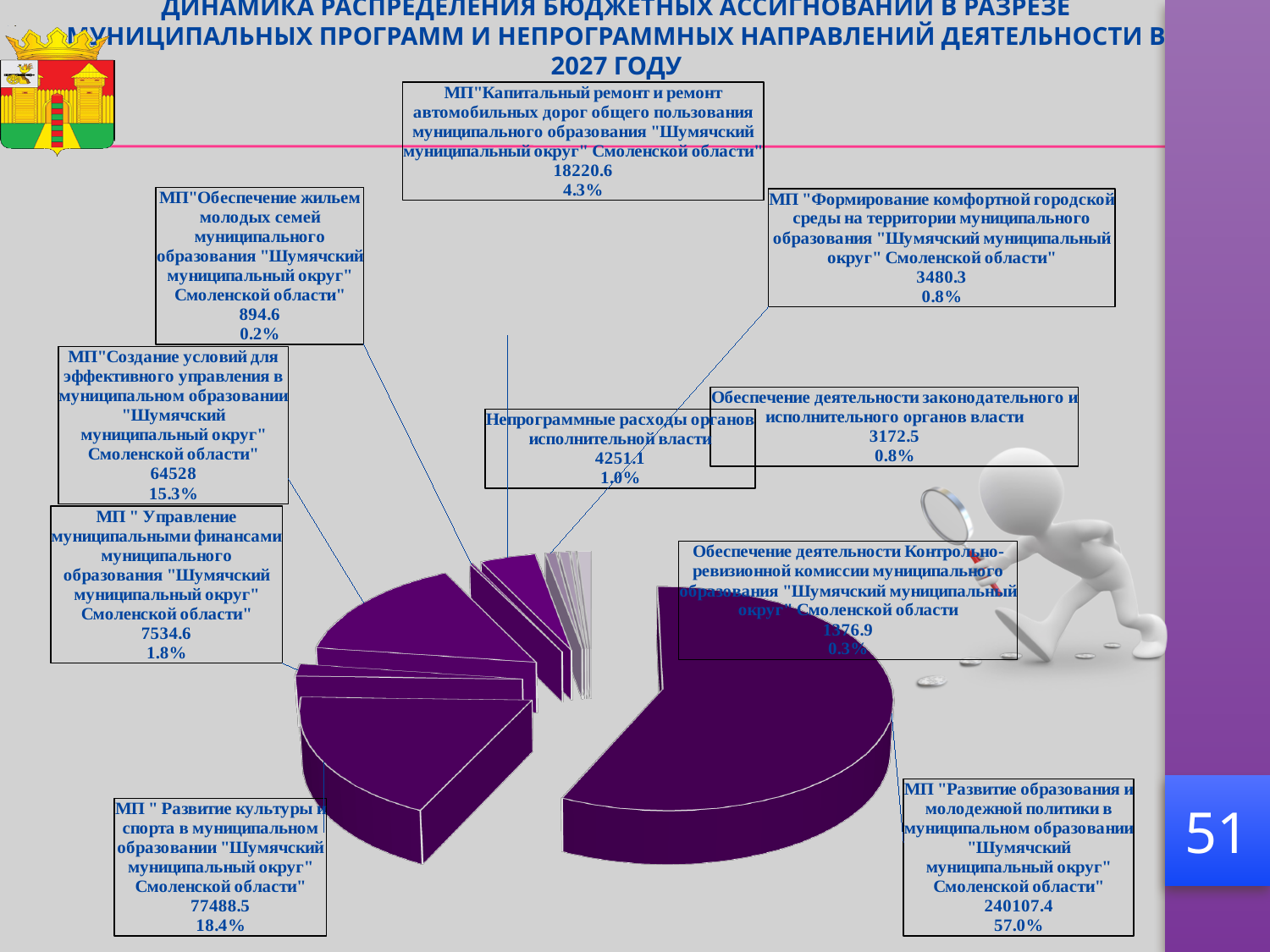
What kind of chart is shown on the slide? pie chart What share of the pie does МП "Развитие культуры и спорта" have? 18.4% How many categories (slices) are labelled on the pie chart? 10 What is the value for МП "Развитие образования и молодежной политики"? 240107.4 What share of the pie does Обеспечение деятельности Контрольно-ревизионной комиссии have? 0.3% What is the value for МП "Капитальный ремонт и ремонт автомобильных дорог"? 18220.6 Which year does the chart title refer to? 2027 What is the difference between the values for МП "Развитие культуры и спорта" (77488.5) and МП "Создание условий для эффективного управления" (64528)? 12960.5 Which category has the smallest share of the pie? МП "Обеспечение жильем молодых семей" Which category has the largest share of the pie? МП "Развитие образования и молодежной политики" What is the value for МП "Формирование комфортной городской среды"? 3480.3 Which is larger: the value for МП "Управление муниципальными финансами" or the value for Непрограммные расходы органов исполнительной власти? МП "Управление муниципальными финансами"